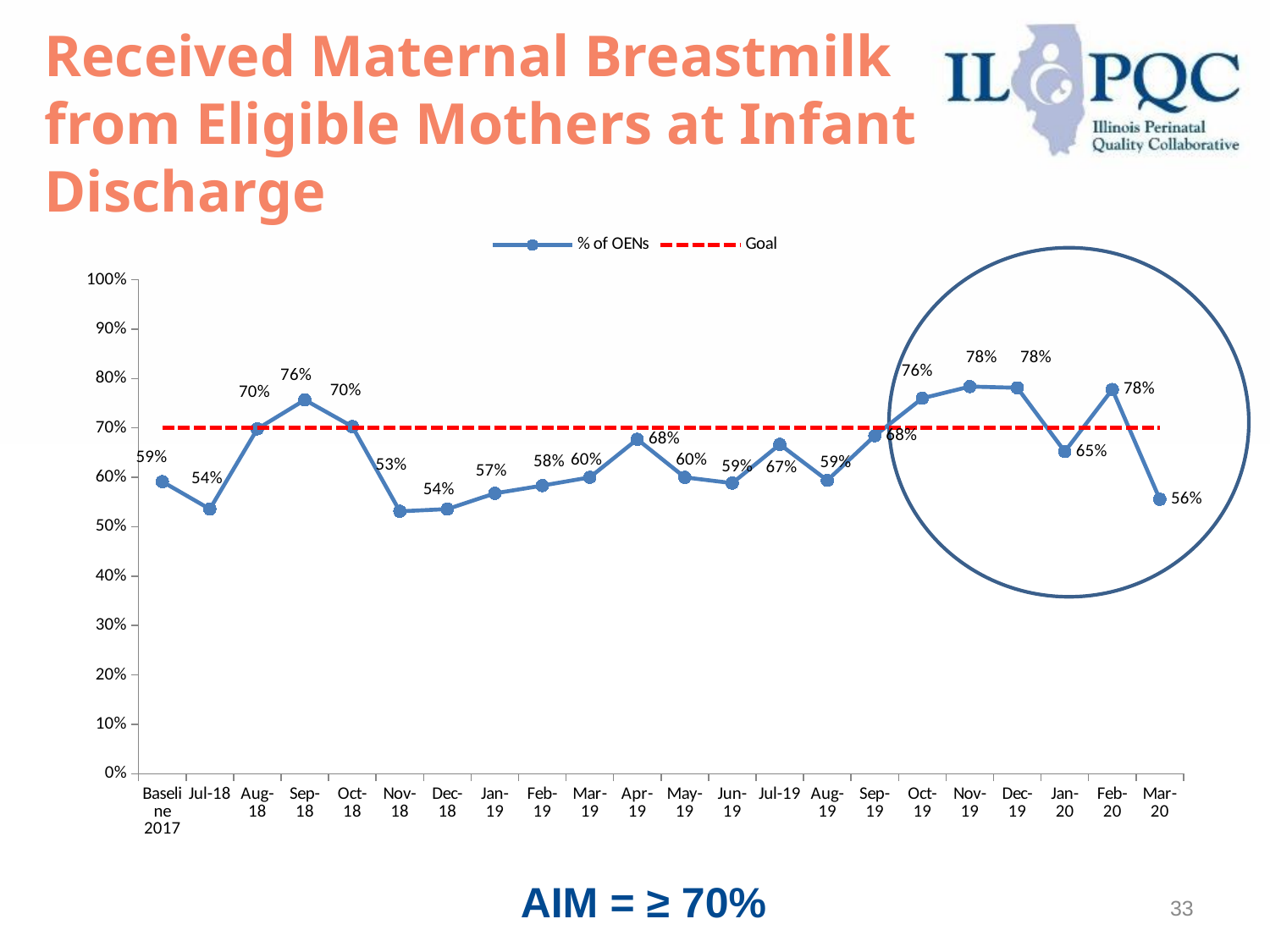
How many series does the legend list? 2 Which month has the lowest % of OENs value? Nov-18 What is the % of OENs value for Mar-20? 56% What is the difference between the % of OENs values for Feb-20 and Mar-20? 22% What is the % of OENs value for Nov-18? 53% At what value is the dashed Goal line drawn? 70% Is the % of OENs value for Dec-19 greater or less than 70%? greater How many data points are plotted on the % of OENs line? 22 Which has a higher % of OENs value, Oct-19 or Jan-20? Oct-19 What kind of chart is shown on the slide? Line chart What is the % of OENs value for the Baseline 2017 point? 59% What is the % of OENs value for Sep-18? 76%